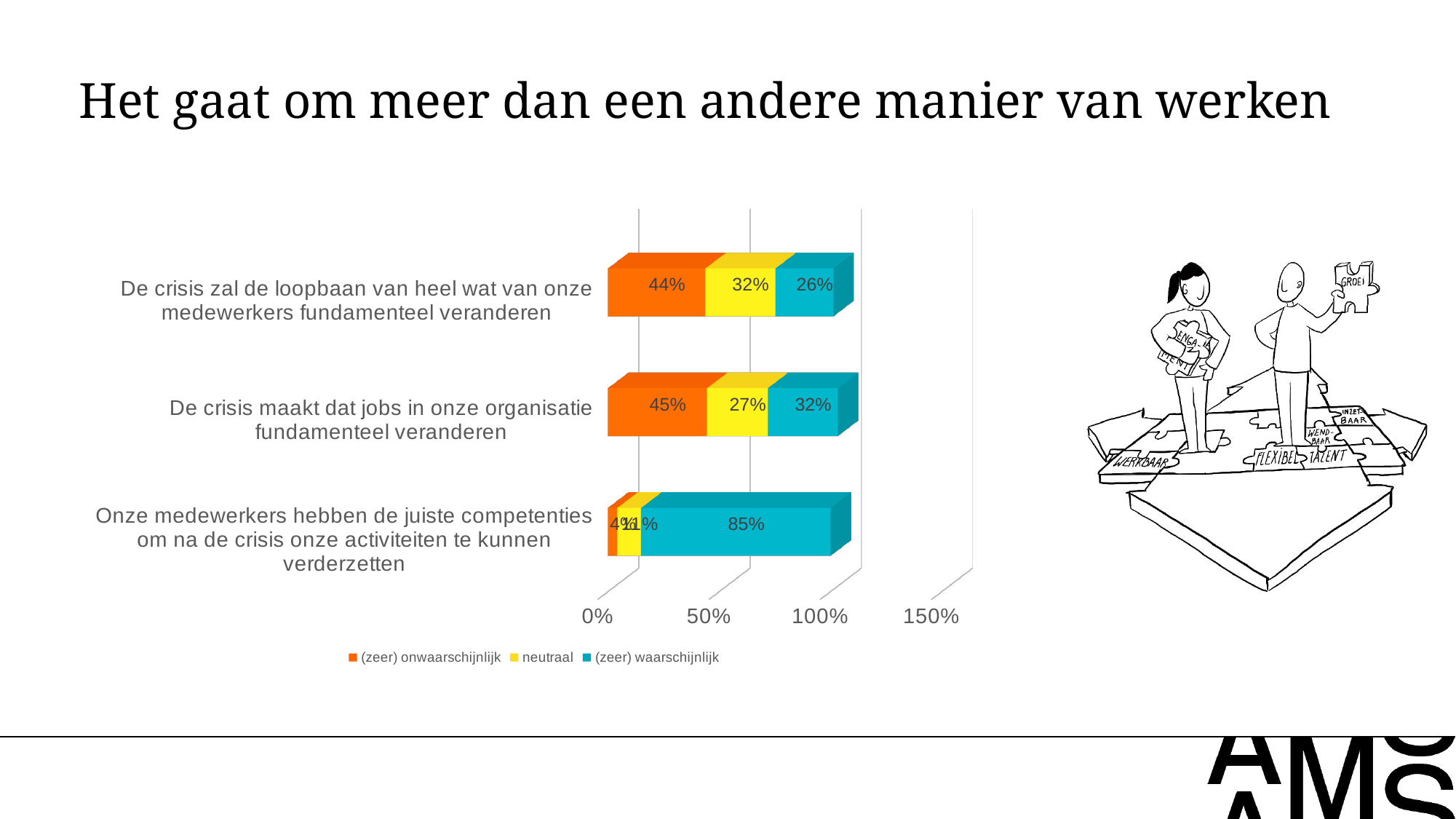
How many statements (categories) are shown in the chart? 3 What is the '(zeer) waarschijnlijk' value for 'Onze medewerkers hebben de juiste competenties om na de crisis onze activiteiten te kunnen verderzetten'? 85% For 'De crisis maakt dat jobs in onze organisatie fundamenteel veranderen', which is larger: the 'neutraal' value or the '(zeer) waarschijnlijk' value? (zeer) waarschijnlijk What kind of chart is shown on the slide? Stacked bar chart How many series does the legend list? 3 What is the '(zeer) waarschijnlijk' value for 'De crisis maakt dat jobs in onze organisatie fundamenteel veranderen'? 32% What is the 'neutraal' value for 'De crisis zal de loopbaan van heel wat van onze medewerkers fundamenteel veranderen'? 32% What percentage of respondents answered '(zeer) onwaarschijnlijk' to 'De crisis zal de loopbaan van heel wat van onze medewerkers fundamenteel veranderen'? 44% What is the difference between the '(zeer) waarschijnlijk' values for 'De crisis maakt dat jobs in onze organisatie fundamenteel veranderen' and 'De crisis zal de loopbaan van heel wat van onze medewerkers fundamenteel veranderen'? 6% What is the '(zeer) onwaarschijnlijk' value for 'De crisis maakt dat jobs in onze organisatie fundamenteel veranderen'? 45% Which statement has the lowest '(zeer) waarschijnlijk' share? De crisis zal de loopbaan van heel wat van onze medewerkers fundamenteel veranderen Which statement has the highest '(zeer) waarschijnlijk' share? Onze medewerkers hebben de juiste competenties om na de crisis onze activiteiten te kunnen verderzetten